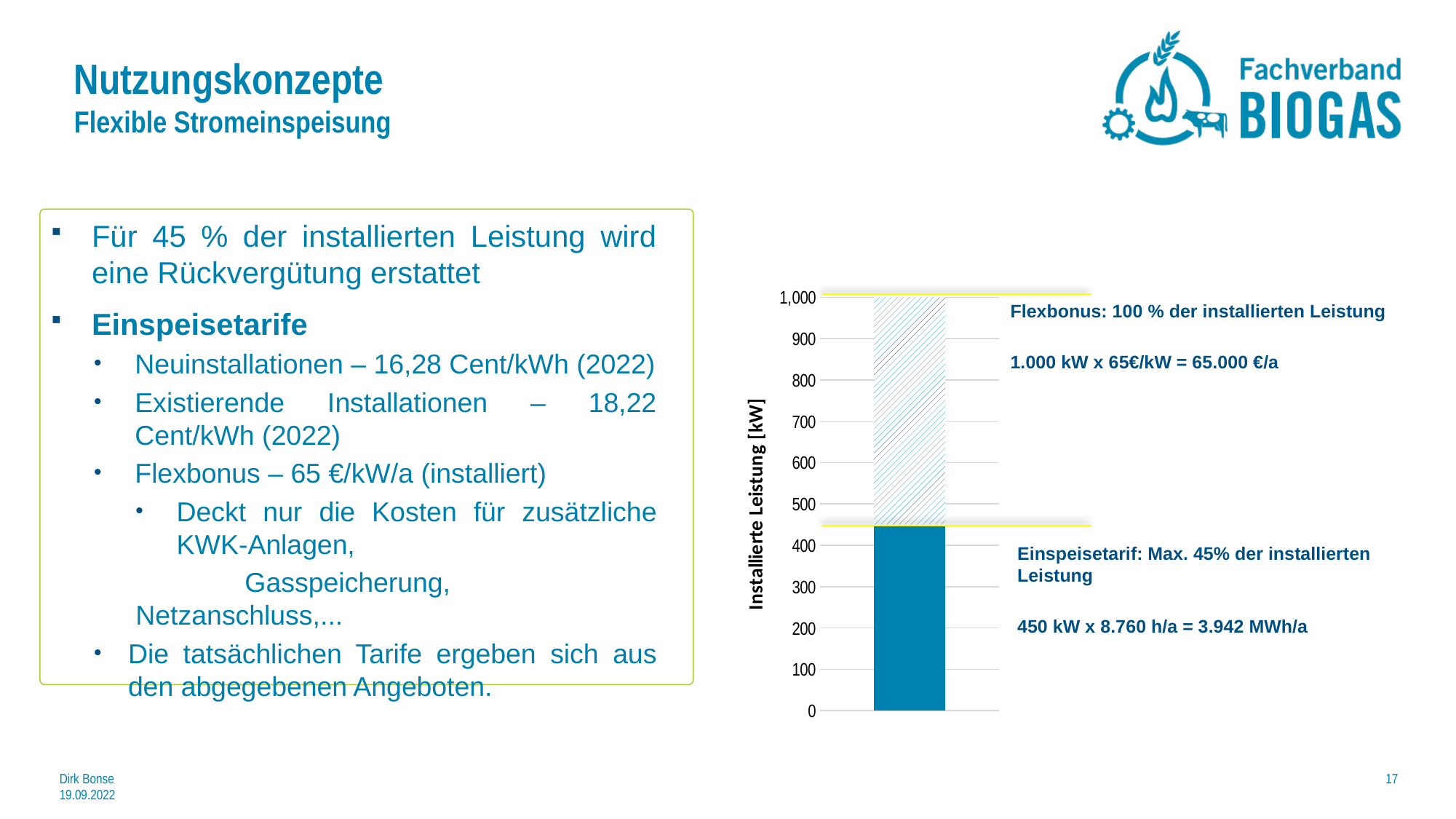
At what value does the top of the hatched portion of the bar end? 1,000 According to the chart annotation, what annual energy results from 450 kW x 8.760 h/a? 3.942 MWh/a What is the highest tick value shown on the vertical axis? 1,000 What is the difference between the top of the hatched portion (1.000 kW) and the top of the solid portion (450 kW)? 550 kW At what value does the solid blue portion of the bar end, according to the annotation? 450 kW What percentage of the installed capacity does the Einspeisetarif cover at most, according to the chart annotation? 45% How many bars does the chart contain? 1 According to the chart annotation, what annual amount results from 1.000 kW x 65€/kW? 65.000 €/a What is the label of the vertical axis of the chart? Installierte Leistung [kW] Is the solid blue portion of the bar greater or less than 500? less What kind of chart is shown on the slide? bar chart Is the solid blue portion of the bar greater or less than 400? greater